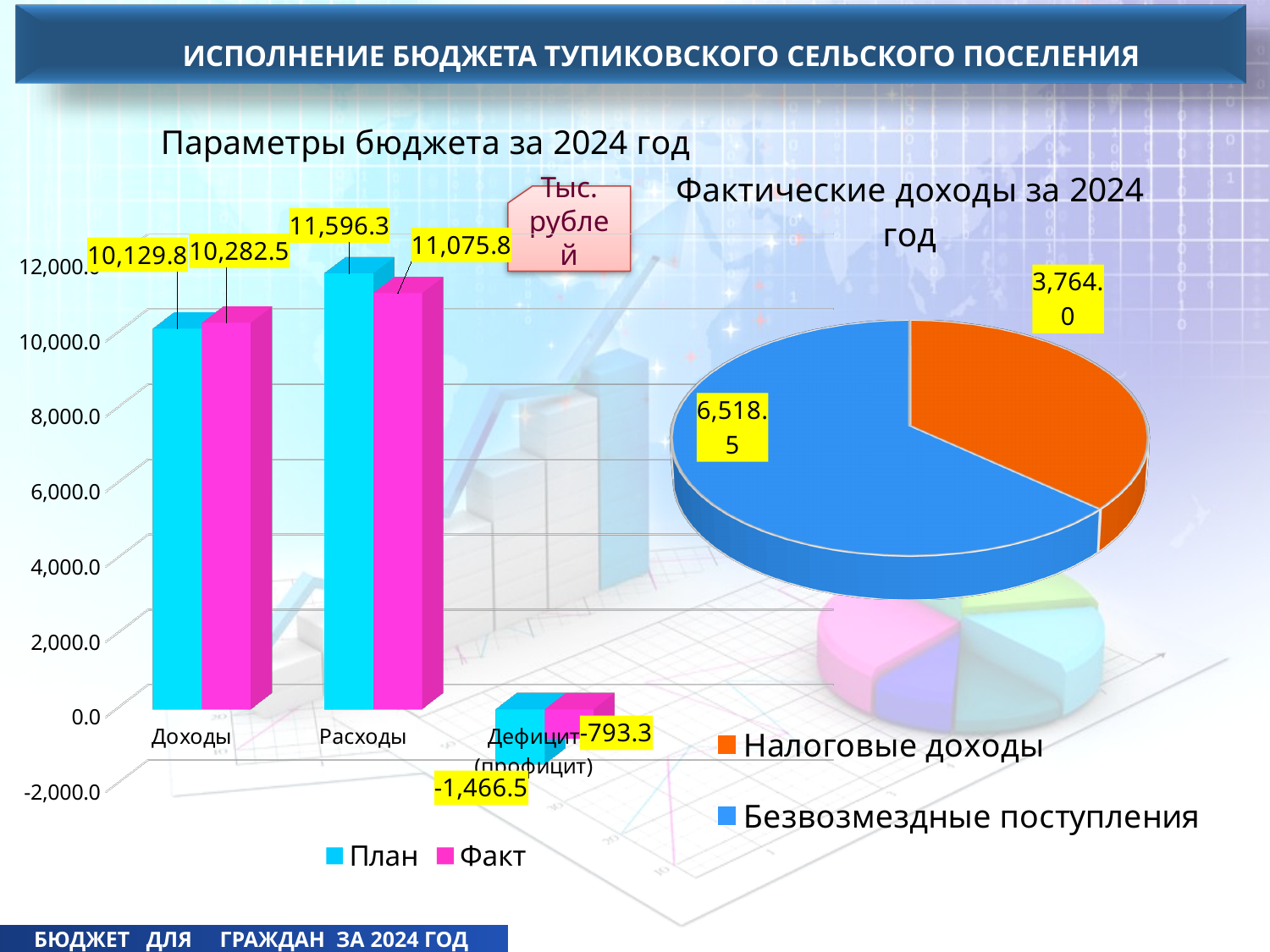
In the pie chart 'Фактические доходы за 2024 год', what colour is the Налоговые доходы slice? Orange In the bar chart 'Параметры бюджета за 2024 год', what is the Факт value for Дефицит (профицит)? -793.3 In the bar chart 'Параметры бюджета за 2024 год', what is the difference between the План and Факт values for Расходы? 520.5 In the bar chart 'Параметры бюджета за 2024 год', which is larger for Доходы: План or Факт? Факт How many categories are shown on the x axis of the bar chart 'Параметры бюджета за 2024 год'? 3 In the pie chart 'Фактические доходы за 2024 год', what is the value for Безвозмездные поступления? 6,518.5 What kind of chart is 'Фактические доходы за 2024 год'? Pie chart In the bar chart 'Параметры бюджета за 2024 год', which category has the highest План value? Расходы How many series does the legend of the bar chart 'Параметры бюджета за 2024 год' list? 2 In the bar chart 'Параметры бюджета за 2024 год', what is the Факт value for Расходы? 11,075.8 In the pie chart 'Фактические доходы за 2024 год', which slice is larger: Налоговые доходы or Безвозмездные поступления? Безвозмездные поступления In the bar chart 'Параметры бюджета за 2024 год', what is the План value for Доходы? 10,129.8